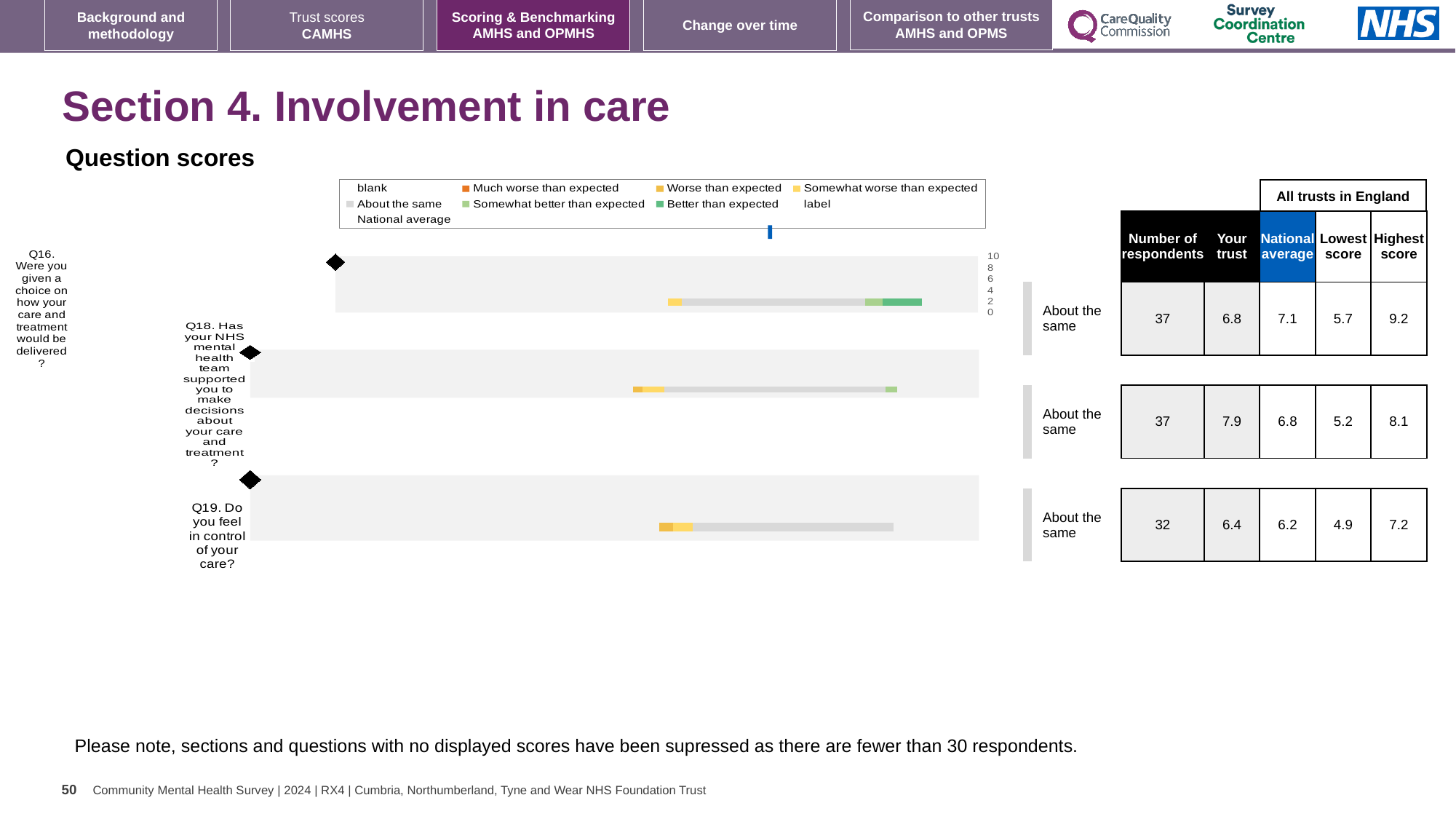
In the table next to the Q16 chart, what is the national average score? 7.1 For Q16, what is the difference between the highest score and the lowest score among all trusts in England? 3.5 For Q18, which is larger: the 'Your trust' score or the national average? Your trust In the table next to the Q18 chart, what is the 'Your trust' score? 7.9 Which question has the fewest respondents in the tables? Q19 How many entries does the legend above the question scores charts list? 9 Which question has the highest 'Your trust' score in the tables? Q18 In the table next to the Q19 chart, what is the highest score among all trusts in England? 7.2 In the table next to the Q16 chart, what is the 'Your trust' score? 6.8 What type of chart is used to show the question scores on this slide? bar chart In the table next to the Q19 chart, how many respondents are there? 32 How many questions (Q16, Q18, Q19) are plotted in the question scores charts? 3